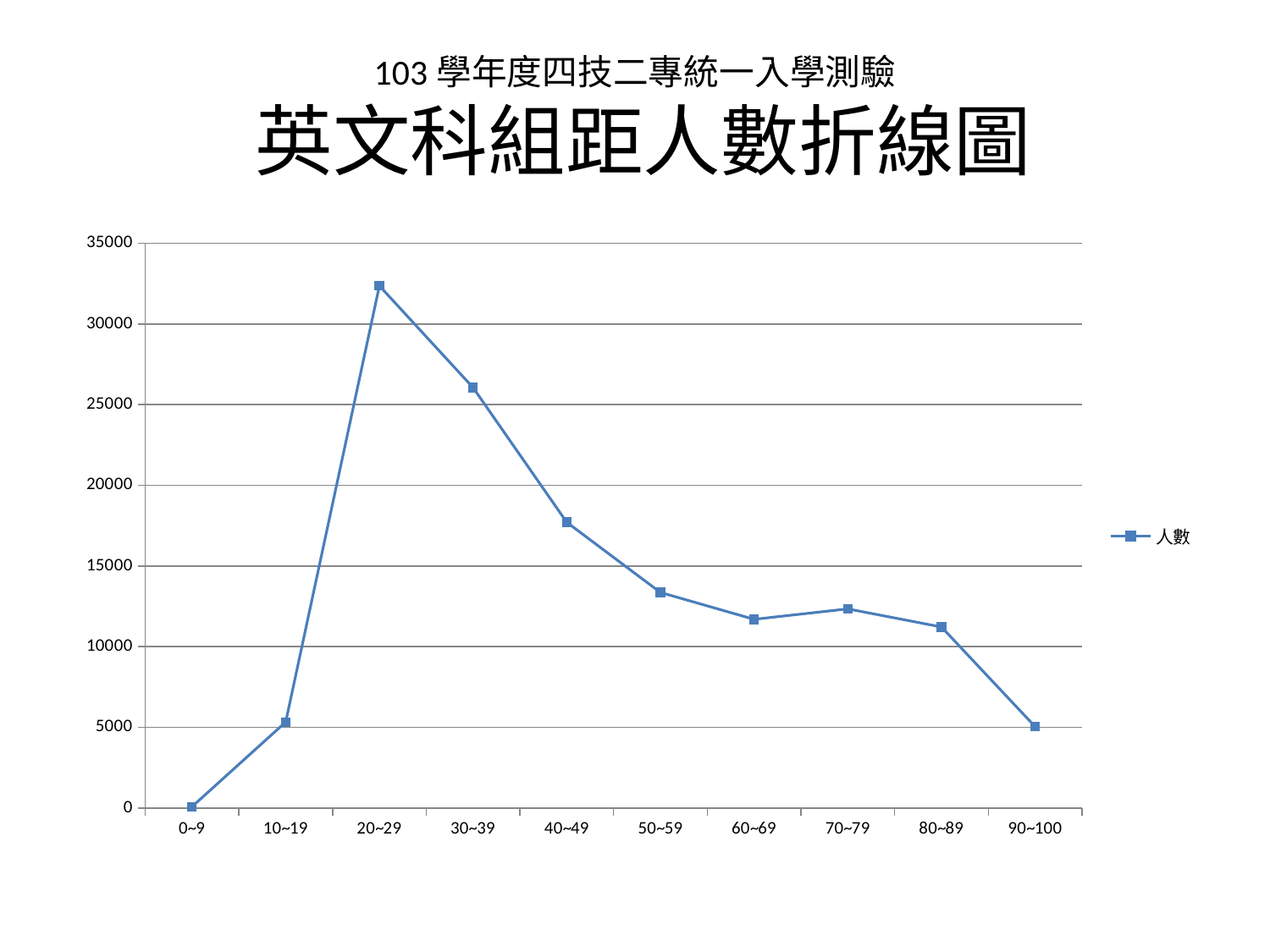
Is the value for 40~49 greater or less than 20000? less Is the value for 80~89 greater or less than 10000? greater Do the values rise or fall from 20~29 to 50~59? fall Which has more people, 30~39 or 40~49? 30~39 Is the value for 20~29 greater or less than 30000? greater What is the name of the series shown in the legend? 人數 How many series does the legend list? 1 What kind of chart is shown on the slide? line chart Which score range has the highest number of people? 20~29 Which score range has the lowest number of people? 0~9 How many score ranges are plotted along the x axis? 10